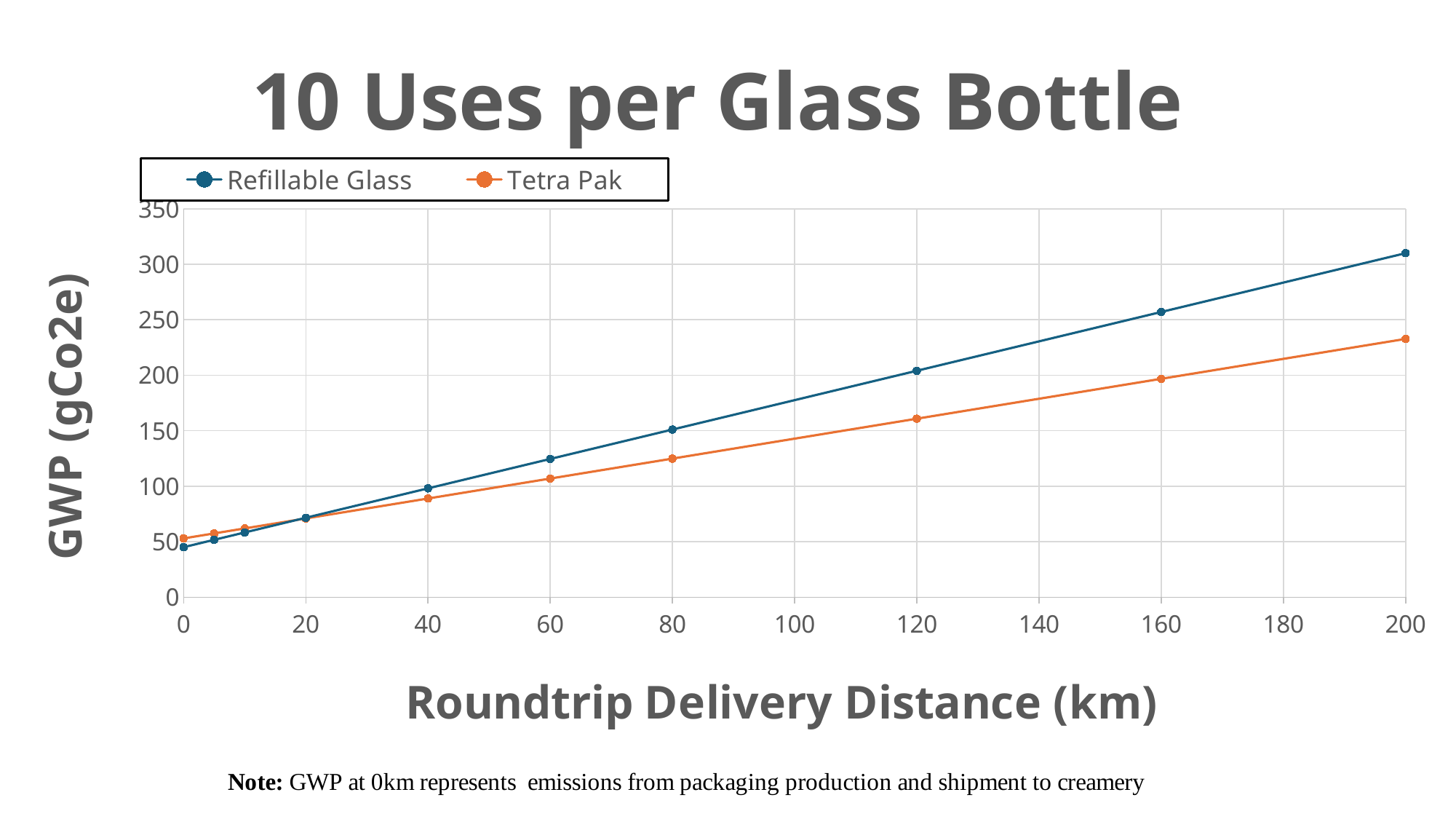
At 200 km, which series has the higher GWP, Refillable Glass or Tetra Pak? Refillable Glass How many series does the legend list? 2 Is the GWP value for Tetra Pak at 80 km greater or less than 100? greater Is the GWP value for Refillable Glass at 200 km greater or less than 300? greater What is the label of the x axis? Roundtrip Delivery Distance (km) What is the title of the chart? 10 Uses per Glass Bottle Do the GWP values for Refillable Glass rise or fall as the roundtrip delivery distance increases? rise What kind of chart is shown on the slide? Line chart Is the GWP value for Tetra Pak at 200 km greater or less than 250? less How many data points are plotted for the Refillable Glass series? 10 At 0 km, which series has the higher GWP, Refillable Glass or Tetra Pak? Tetra Pak